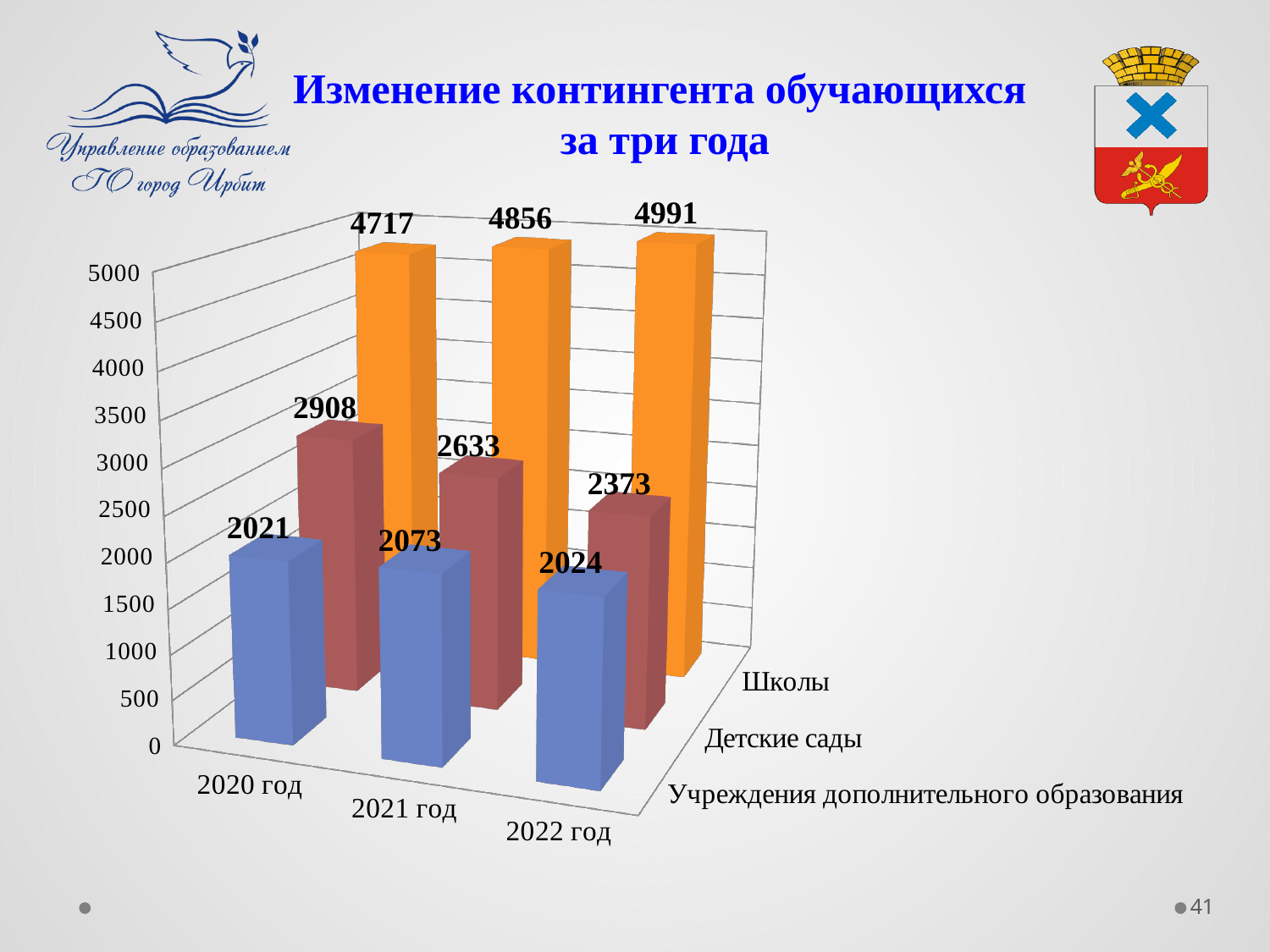
What is the difference between the Школы values for 2022 год and 2020 год? 274 Do the values for Детские сады rise or fall from 2020 год to 2022 год? fall In which year is the value for Школы the highest? 2022 год What kind of chart is shown on the slide? bar chart Do the values for Школы rise or fall from 2020 год to 2022 год? rise In which year is the value for Детские сады the lowest? 2022 год What is the difference between the Детские сады values for 2020 год and 2022 год? 535 Which is larger: Детские сады in 2021 год or Учреждения дополнительного образования in 2021 год? Детские сады in 2021 год What is the value for Детские сады in 2020 год? 2908 What is the value for Учреждения дополнительного образования in 2021 год? 2073 How many years are shown on the x axis of the chart? 3 What is the value for Школы in 2022 год? 4991